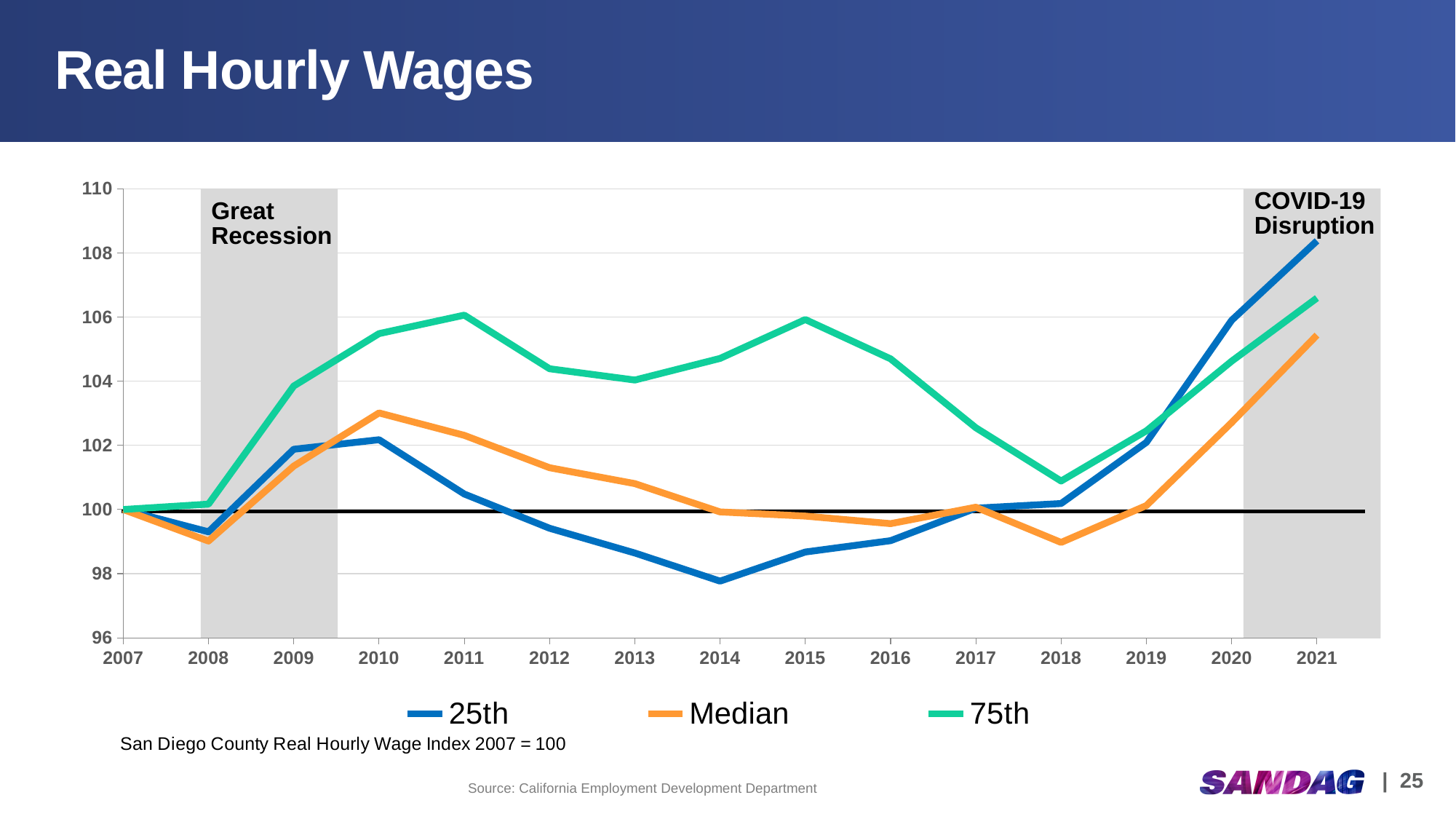
Is the value for the 25th series in 2021 greater or less than 106? greater How many series does the legend list? 3 What kind of chart is shown on the slide? line chart Which series has the highest value in 2021? 25th Is the value for the 25th series in 2014 greater or less than 100? less How many years are plotted along the x axis? 15 In which year is the 25th series at its lowest? 2014 Does the 25th series rise or fall from 2010 to 2014? fall Is the value for the Median series in 2010 greater or less than 102? greater In which year is the Median series at its highest? 2021 In 2010, which is larger: the 75th series or the 25th series? 75th